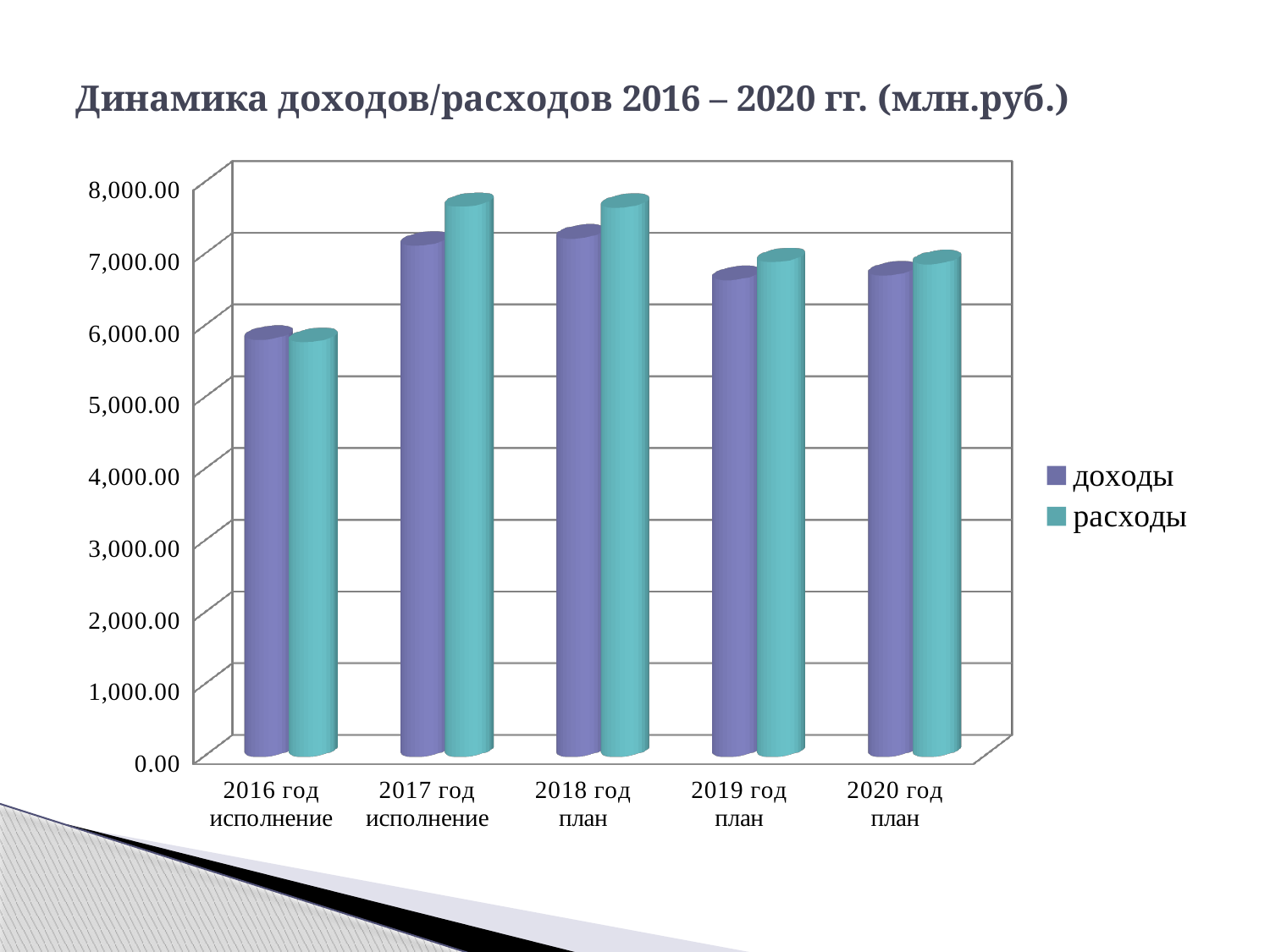
Is the value of доходы for 2018 год план greater or less than 7,000.00? greater What is the title of the chart? Динамика доходов/расходов 2016 – 2020 гг. (млн.руб.) Which year has the lowest value of доходы? 2016 год исполнение Is the value of расходы for 2017 год исполнение greater or less than 7,000.00? greater For 2017 год исполнение, which is larger: доходы or расходы? расходы Is the value of доходы for 2019 год план greater or less than 7,000.00? less Which is larger: доходы for 2018 год план or доходы for 2019 год план? 2018 год план What are the two series named in the legend? доходы and расходы How many year categories are shown on the x axis? 5 What kind of chart is shown on the slide? bar chart How many series does the legend list? 2